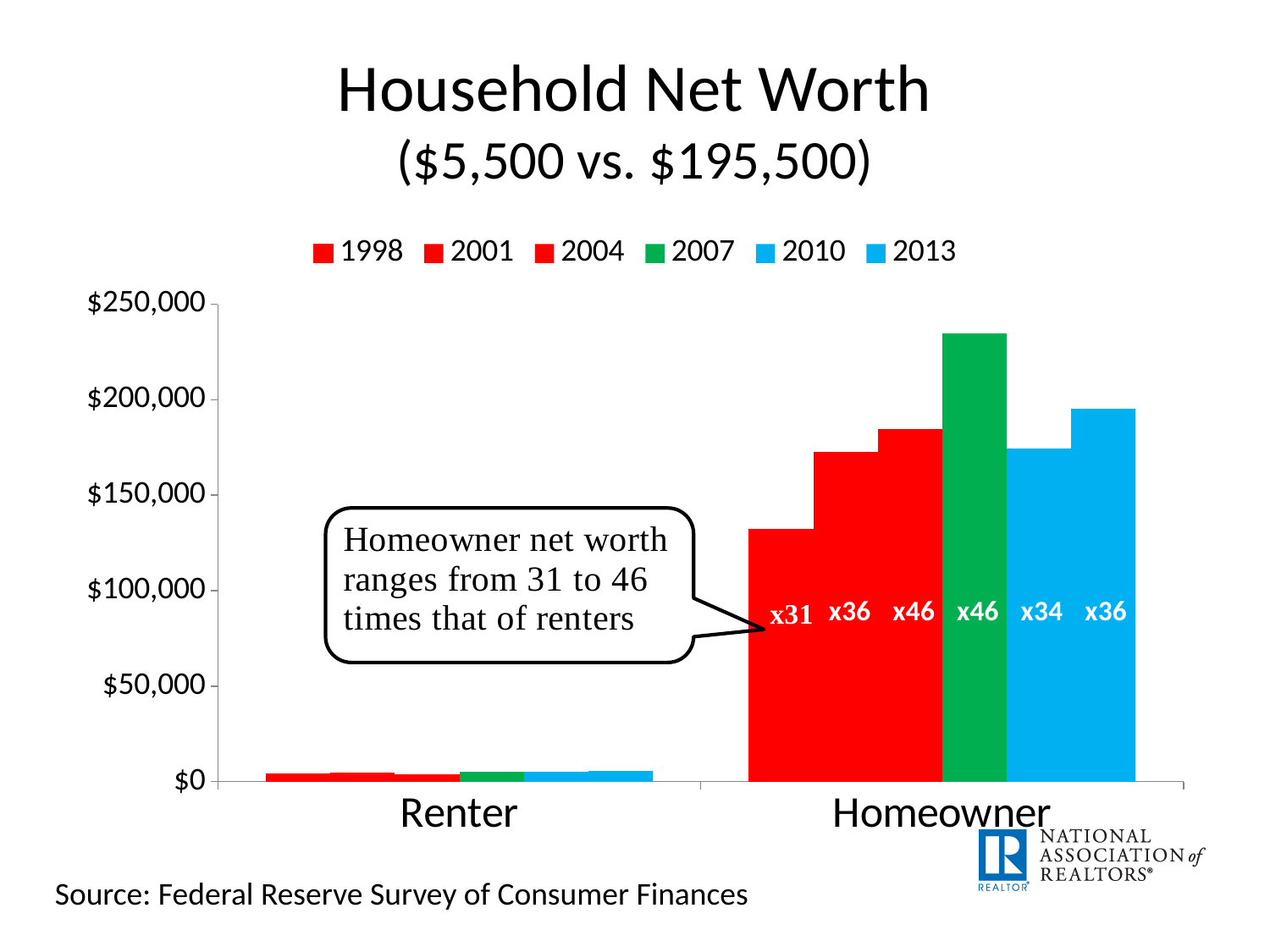
How many series does the legend list? 6 Which year has the highest net worth for Homeowner? 2007 How many categories are shown on the x axis? 2 What kind of chart is shown on the slide? bar chart What two dollar amounts are shown in the chart's subtitle? $5,500 vs. $195,500 For Homeowner, which is larger: the 2007 value or the 2013 value? 2007 Is the value for Renter in 2013 greater or less than $50,000? less Is the value for Homeowner in 1998 greater or less than $150,000? less Do the Homeowner values rise or fall from 1998 to 2007? rise Which year has the lowest net worth for Homeowner? 1998 What multiplier label is printed on the 2007 Homeowner bar? x46 Is the value for Homeowner in 2007 greater or less than $200,000? greater